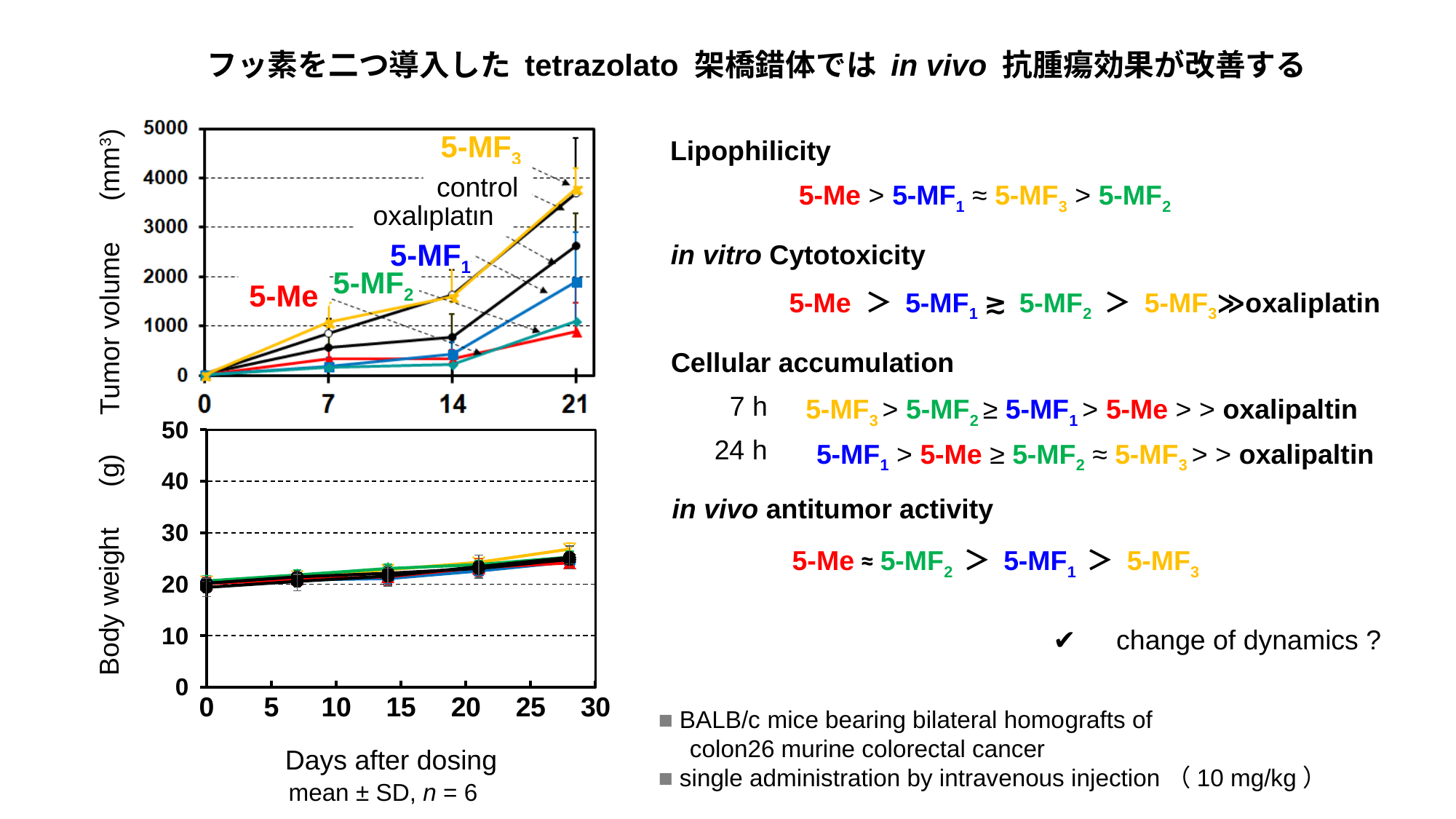
In the top chart (Tumor volume), is the value for 5-Me at day 14 greater or less than 1000? less What kind of chart is the top chart (Tumor volume)? line chart In the top chart (Tumor volume), how many time points are plotted along the x axis? 4 In the top chart (Tumor volume), is the value for 5-MF3 at day 21 greater or less than 3000? greater What is the x-axis label shared by the two charts? Days after dosing In the top chart (Tumor volume), which is larger at day 21: the value for oxaliplatin or the value for 5-Me? oxaliplatin In the top chart (Tumor volume), is the value for 5-MF2 at day 21 greater or less than 2000? less In the bottom chart (Body weight), do the body weight values rise or fall along the x axis? rise In the top chart (Tumor volume), how many series are labelled on the plot? 6 In the top chart (Tumor volume), does the tumor volume for control rise or fall from day 0 to day 21? rise